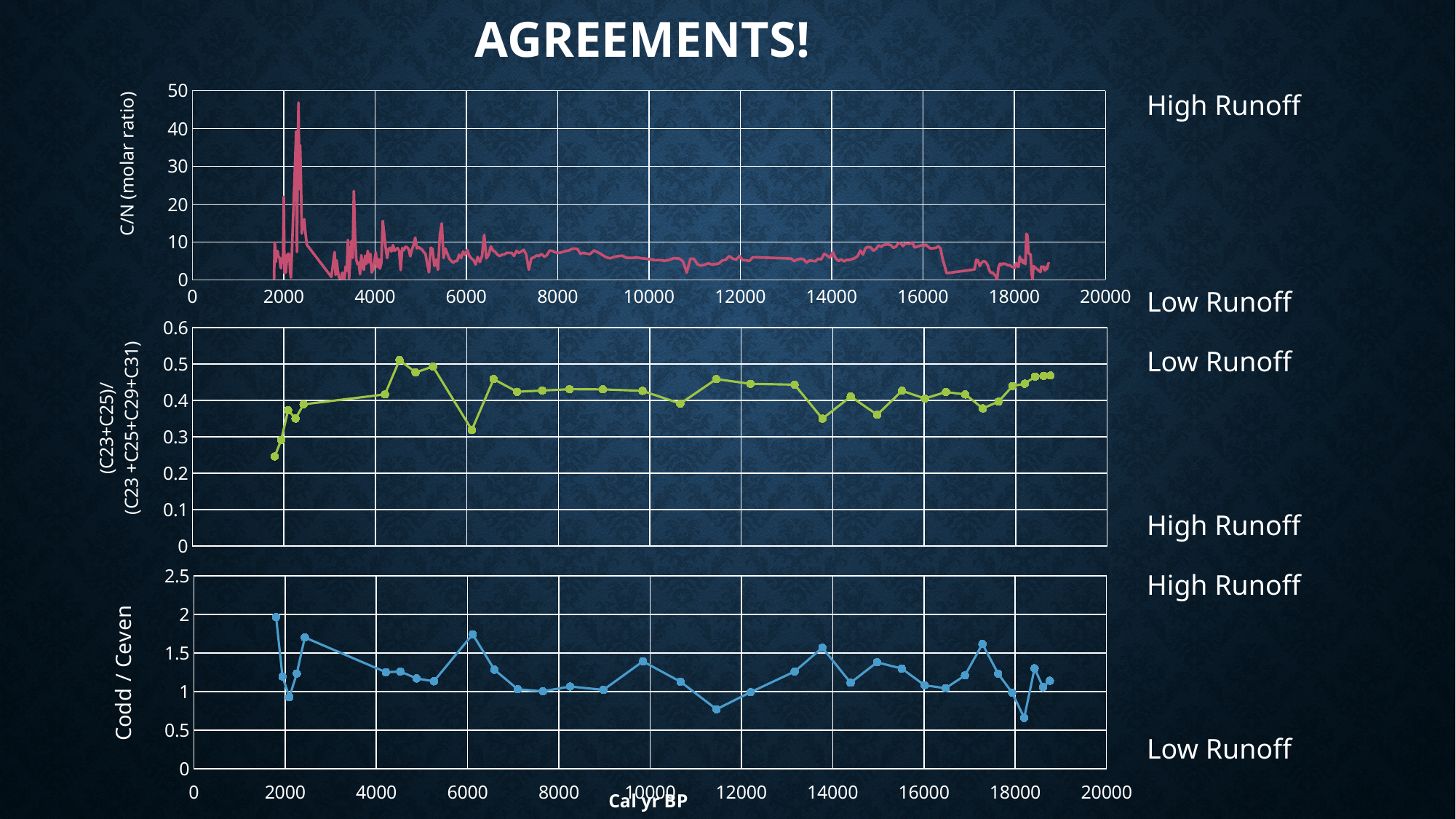
In the middle chart ((C23+C25)/(C23+C25+C29+C31)), is the value at about 6100 Cal yr BP greater or less than 0.4? less In the top chart (C/N molar ratio), is the highest peak, near 2300 Cal yr BP, greater or less than 40? greater How many charts are shown on the slide? 3 What is the y-axis label of the bottom chart? Codd / Ceven What is the x-axis label shared by the charts on the slide? Cal yr BP In the middle chart ((C23+C25)/(C23+C25+C29+C31)), do the values rise or fall between about 1800 and 4500 Cal yr BP? rise What kind of chart is the bottom chart (Codd / Ceven)? line chart In the middle chart ((C23+C25)/(C23+C25+C29+C31)), is the first point, near 1800 Cal yr BP, greater or less than 0.3? less What kind of chart is the top chart (C/N molar ratio)? line chart